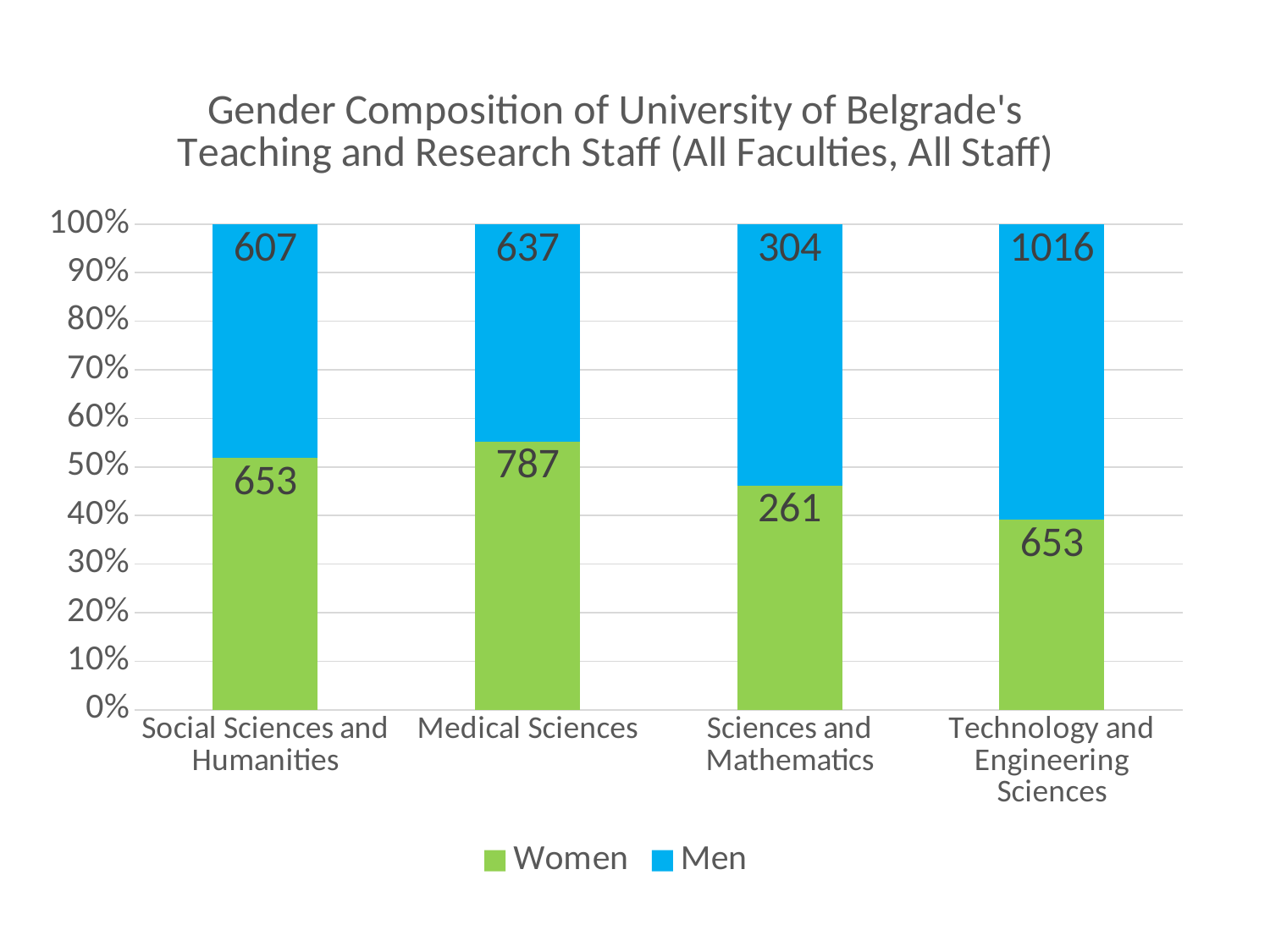
How many faculty groups are shown on the x axis? 4 How many series does the legend list? 2 Are there more women or men on the staff in Medical Sciences? Women Which faculty group has the lowest number of women? Sciences and Mathematics How many women are on the staff in Sciences and Mathematics? 261 How many men are on the teaching and research staff in Technology and Engineering Sciences? 1016 What is the difference between the number of men and the number of women in Technology and Engineering Sciences? 363 What is the total number of staff in Social Sciences and Humanities? 1260 Is the share of women in Technology and Engineering Sciences greater or less than 40%? less How many women are on the teaching and research staff in Medical Sciences? 787 Which faculty group has the highest number of men? Technology and Engineering Sciences What kind of chart is shown on the slide? Stacked bar chart